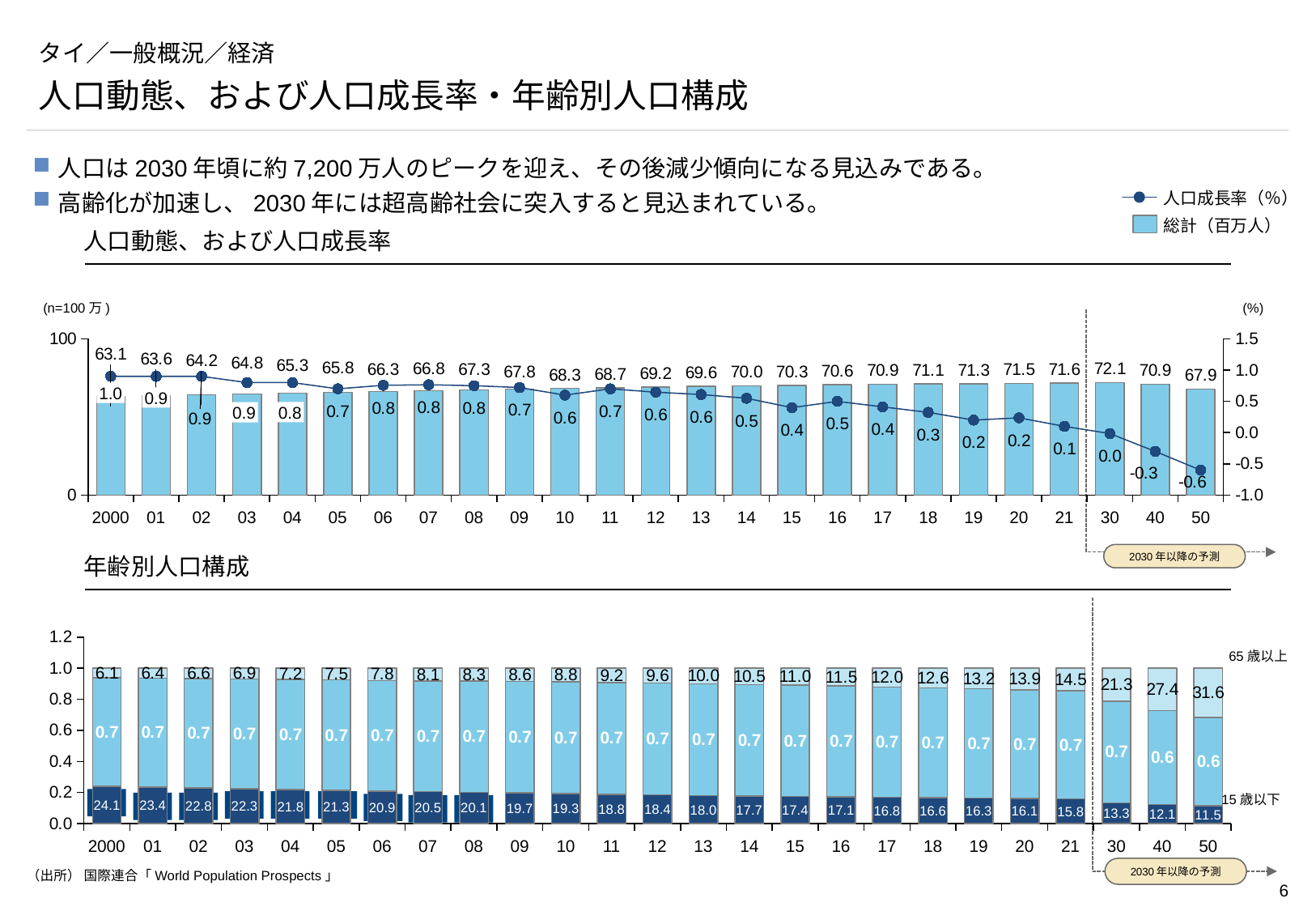
In the top chart (人口動態、および人口成長率), what is the 総計 value for 2000? 63.1 In the top chart (人口動態、および人口成長率), which year has the lowest 人口成長率 value? 50 In the top chart (人口動態、および人口成長率), what is the 人口成長率 value for 50? -0.6 In the bottom chart (年齢別人口構成), what is the 15歳以下 value for 2000? 24.1 In the bottom chart (年齢別人口構成), what is the 65歳以上 value for 50? 31.6 In the top chart (人口動態、および人口成長率), what is the difference between the 総計 values for 30 and 50? 4.2 What type of chart is the bottom chart (年齢別人口構成)? stacked bar chart In the top chart (人口動態、および人口成長率), which is larger, the 総計 value for 21 or for 40? 21 In the top chart (人口動態、および人口成長率), does the 人口成長率 line generally rise or fall from 2000 to 50? fall In the top chart (人口動態、および人口成長率), how many series does the legend list? 2 In the top chart (人口動態、および人口成長率), which year has the highest 総計 value? 30 In the bottom chart (年齢別人口構成), how many years are shown on the x axis? 25